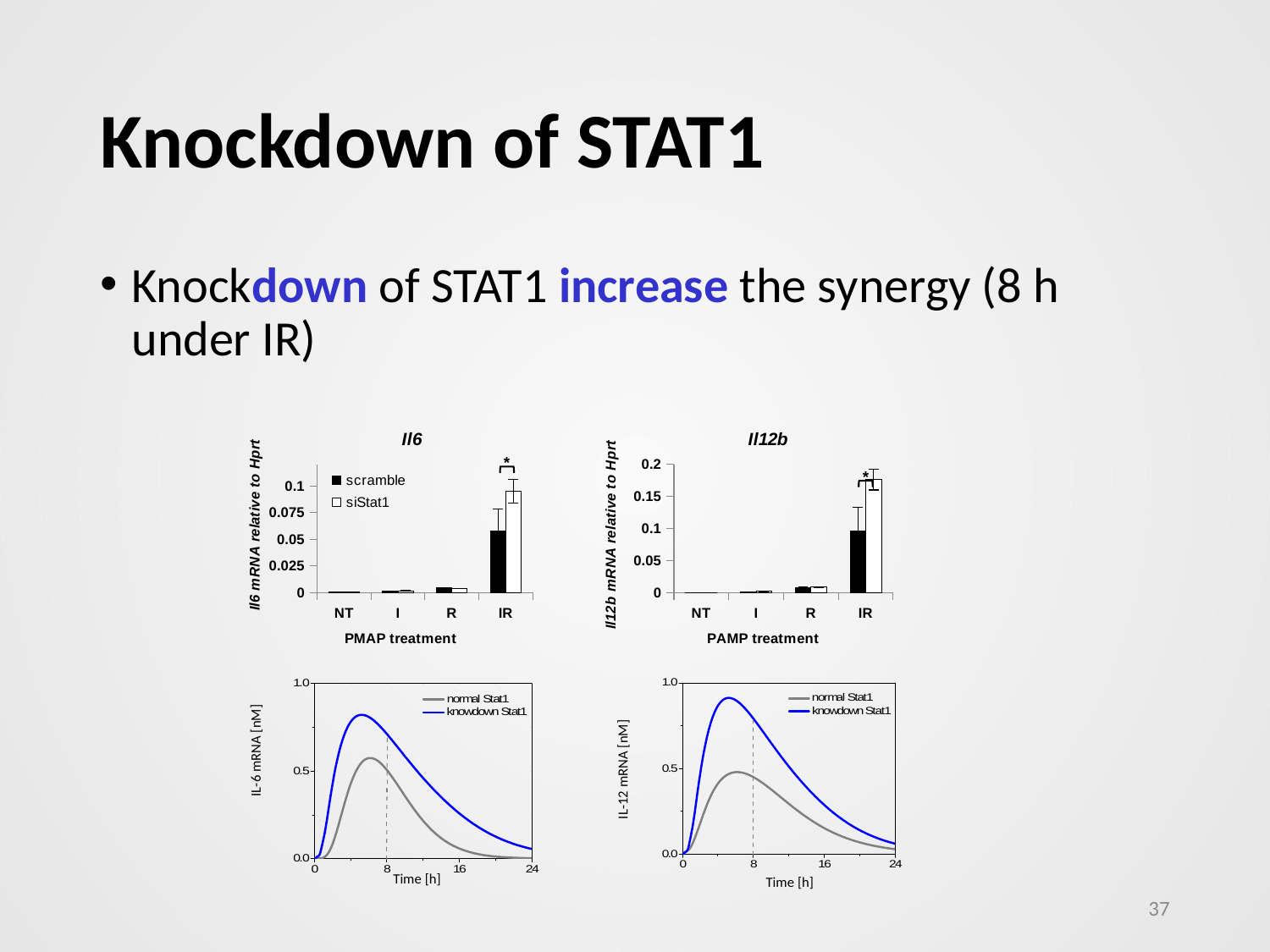
In the Il12b bar chart, is the scramble value for IR greater or less than 0.15? less In the IL-12 mRNA [nM] line chart, which series reaches the higher peak, normal Stat1 or knowdown Stat1? knowdown Stat1 In the Il6 bar chart, how many series does the legend list? 2 In the Il6 bar chart, is the siStat1 value for IR greater or less than 0.075? greater In the Il12b bar chart, is the siStat1 value for IR greater or less than 0.15? greater In the Il12b bar chart, which PAMP treatment has the highest Il12b mRNA relative to Hprt? IR In the Il6 bar chart, which series has the larger value for IR, scramble or siStat1? siStat1 In the Il6 bar chart, how many treatment categories are shown on the x axis? 4 In the Il6 bar chart, which PMAP treatment has the highest Il6 mRNA relative to Hprt? IR What kind of chart is the IL-6 mRNA [nM] versus Time [h] chart at the bottom left? line chart In the IL-6 mRNA [nM] line chart, does the knowdown Stat1 curve rise or fall between 8 h and 24 h? fall